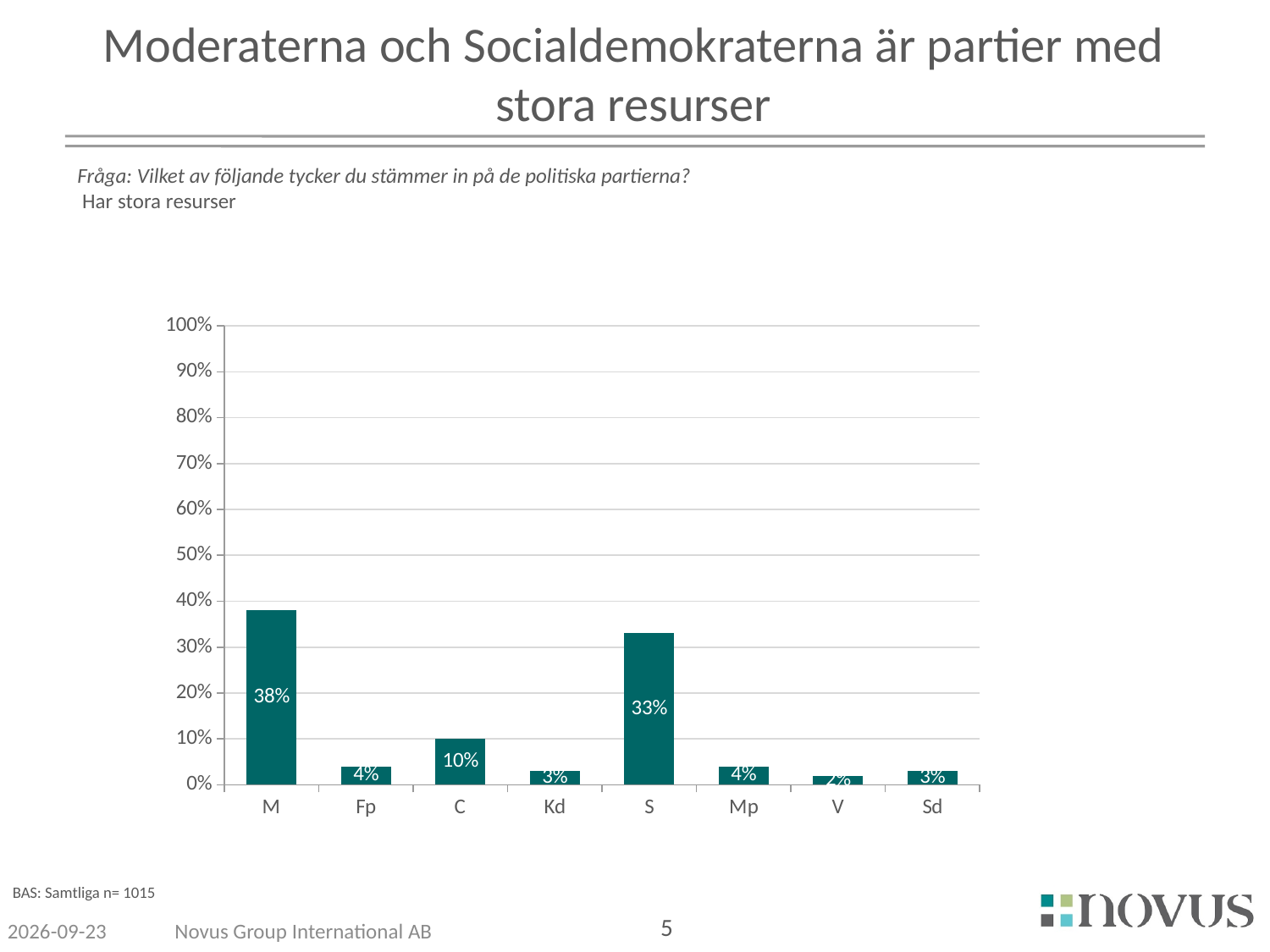
What is the value for Fp? 4% Which is larger, the value for C or the value for Mp? C What kind of chart is shown on the slide? bar chart What is the value for S? 33% How many parties are shown on the x axis? 8 What is the value for Kd? 3% What is the highest value shown on the y axis? 100% What is the difference between the values for M and S? 5% Is the value for S greater or less than 30%? greater Which party has the highest value? M What is the value for M? 38% What is the value for C? 10%